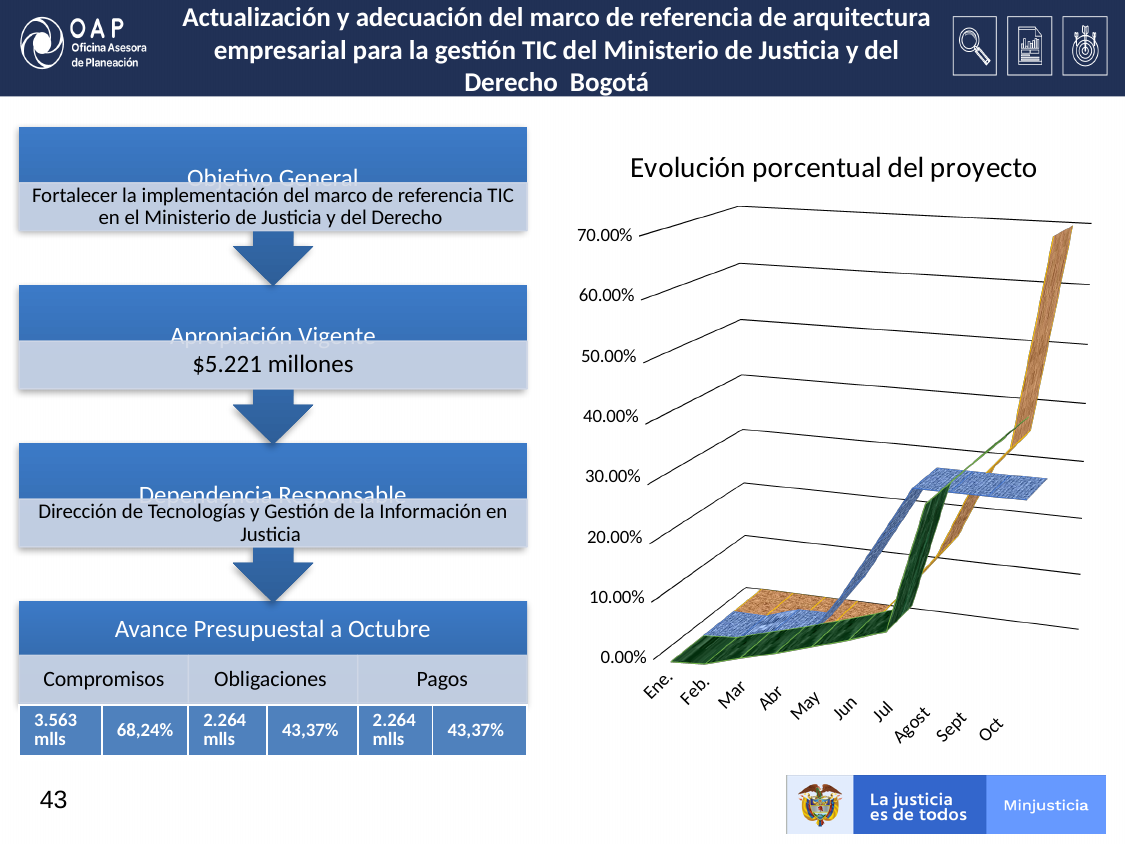
In the 'Evolución porcentual del proyecto' chart, is the value for Ene. greater or less than 10.00%? less In the 'Evolución porcentual del proyecto' chart, is the value for Oct larger or smaller than the value for Feb.? larger What is the highest tick value shown on the vertical axis of the 'Evolución porcentual del proyecto' chart? 70.00% What is the title of the chart on the right side of the slide? Evolución porcentual del proyecto What is the first category on the x axis of the 'Evolución porcentual del proyecto' chart? Ene. How many months are shown on the x axis of the 'Evolución porcentual del proyecto' chart? 10 In the 'Evolución porcentual del proyecto' chart, is the value of the orange series for Oct greater or less than 40.00%? greater In the 'Evolución porcentual del proyecto' chart, which month has the highest value? Oct What is the last category on the x axis of the 'Evolución porcentual del proyecto' chart? Oct Do the values in the 'Evolución porcentual del proyecto' chart generally rise or fall from Ene. to Oct? rise What kind of chart is 'Evolución porcentual del proyecto'? line chart